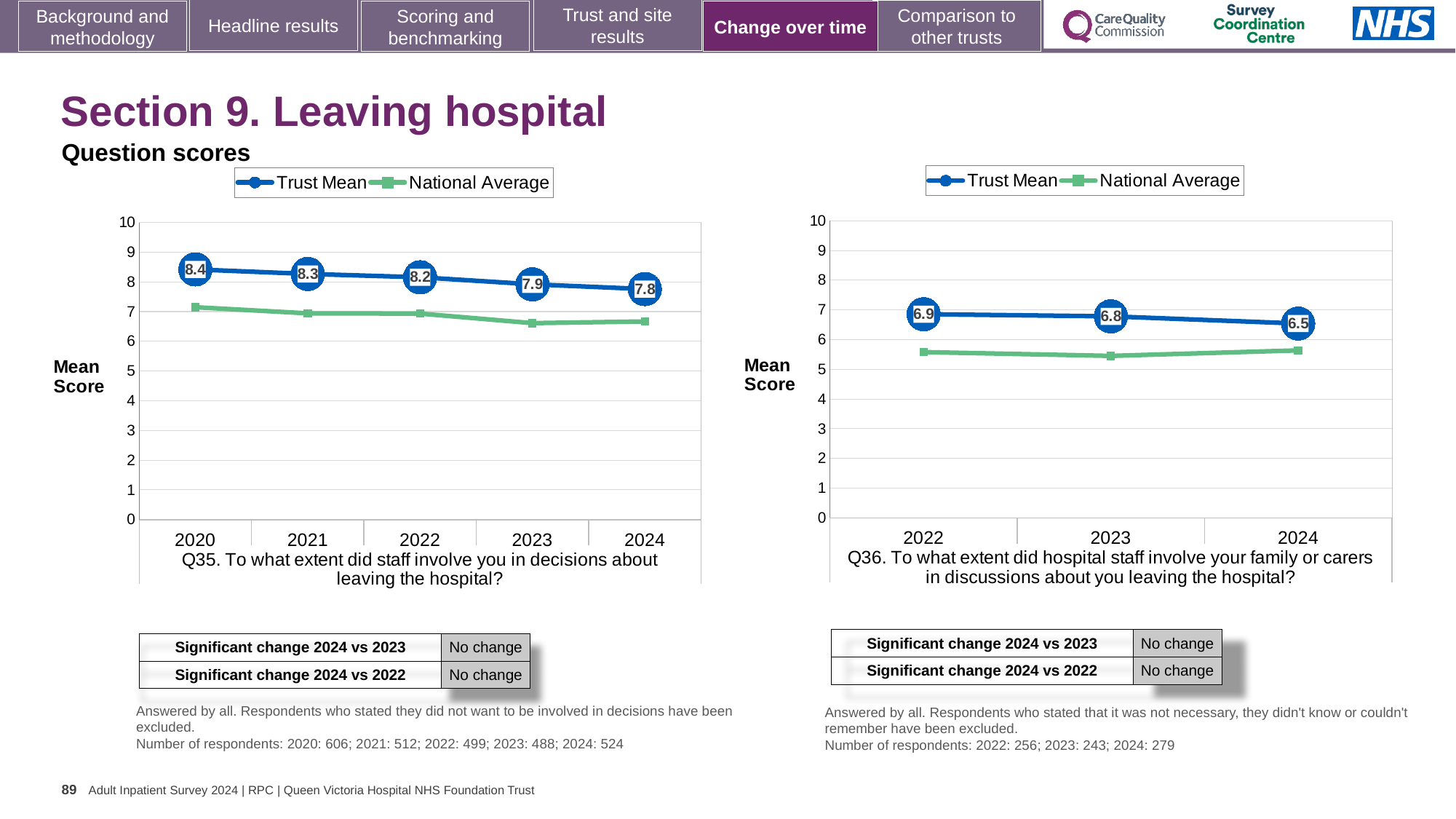
In the Q36 chart on the right, what is the difference between the Trust Mean scores for 2022 and 2024? 0.4 In the Q36 chart on the right, is the National Average for 2024 greater or less than 6? less In the Q36 chart on the right, which year has the highest Trust Mean score? 2022 How many series does the legend of the Q36 chart on the right list? 2 In the Q35 chart on the left, which year has the lowest Trust Mean score? 2024 In the Q36 chart on the right, what is the Trust Mean score for 2023? 6.8 In the Q35 chart on the left, what is the Trust Mean score for 2020? 8.4 In the Q35 chart on the left, does the Trust Mean rise or fall from 2020 to 2024? fall In the Q35 chart on the left, what is the Trust Mean score for 2024? 7.8 In the Q35 chart on the left, how many years are shown on the x axis? 5 In the Q35 chart on the left, what is the difference between the Trust Mean scores for 2020 and 2024? 0.6 In the Q35 chart on the left, is the National Average for 2020 greater or less than 8? less